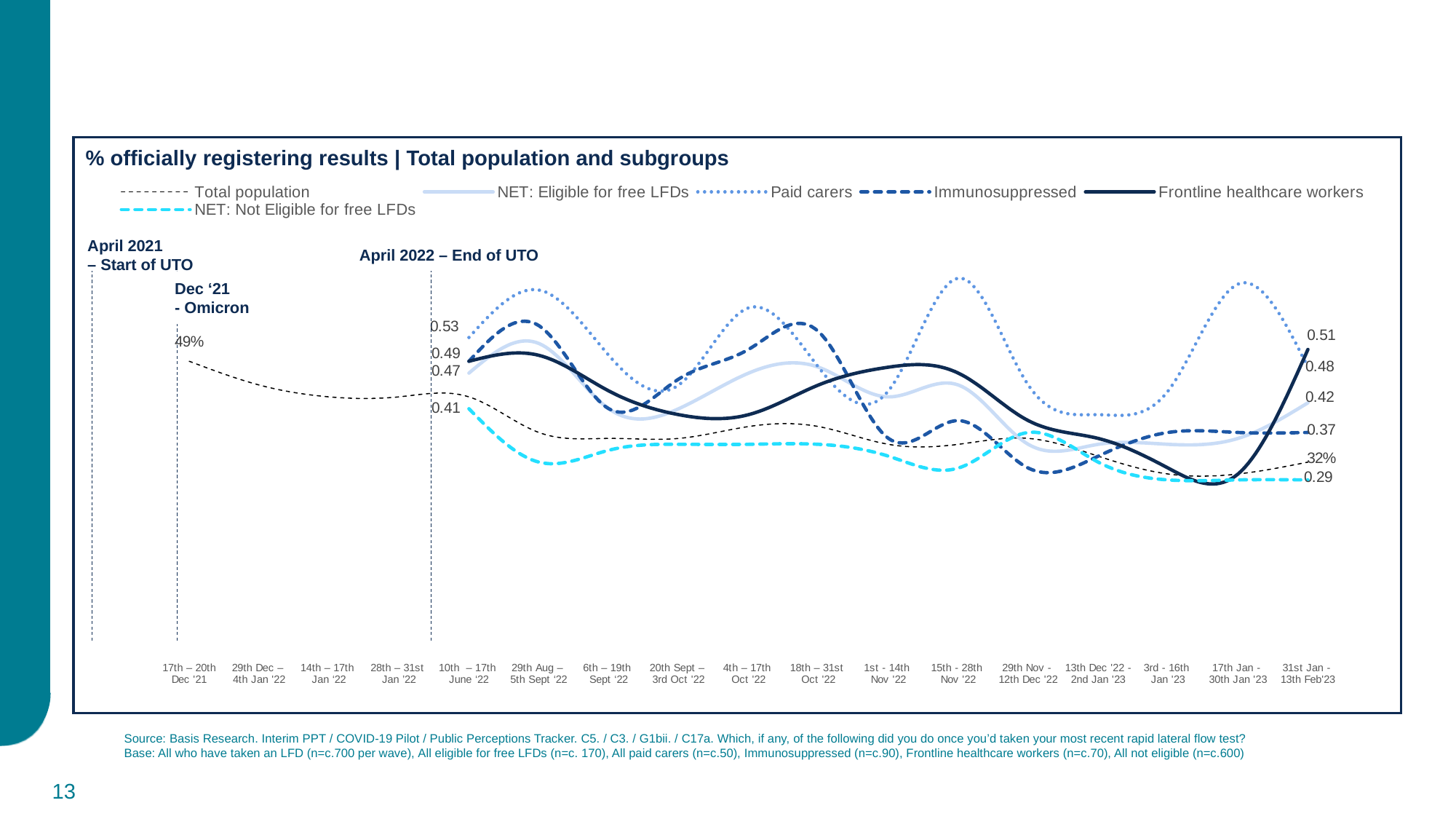
What is the value for NET: Not Eligible for free LFDs at 31st Jan – 13th Feb '23? 0.29 What is the value for Immunosuppressed at 31st Jan – 13th Feb '23? 0.37 What is the value for NET: Eligible for free LFDs at 31st Jan – 13th Feb '23? 0.42 Which series has the lowest value at 31st Jan – 13th Feb '23? NET: Not Eligible for free LFDs How many time periods are labelled along the x axis? 17 What is the Total population value for 17th – 20th Dec '21? 49% By how many percentage points did the Total population value fall between 17th – 20th Dec '21 and 31st Jan – 13th Feb '23? 17 percentage points What is the Total population value for 31st Jan – 13th Feb '23? 32% What type of chart is shown on the slide? Line chart How many series does the legend list? 6 At 31st Jan – 13th Feb '23, which is higher: NET: Eligible for free LFDs or NET: Not Eligible for free LFDs? NET: Eligible for free LFDs What is the value for Paid carers at 10th – 17th June '22? 0.53